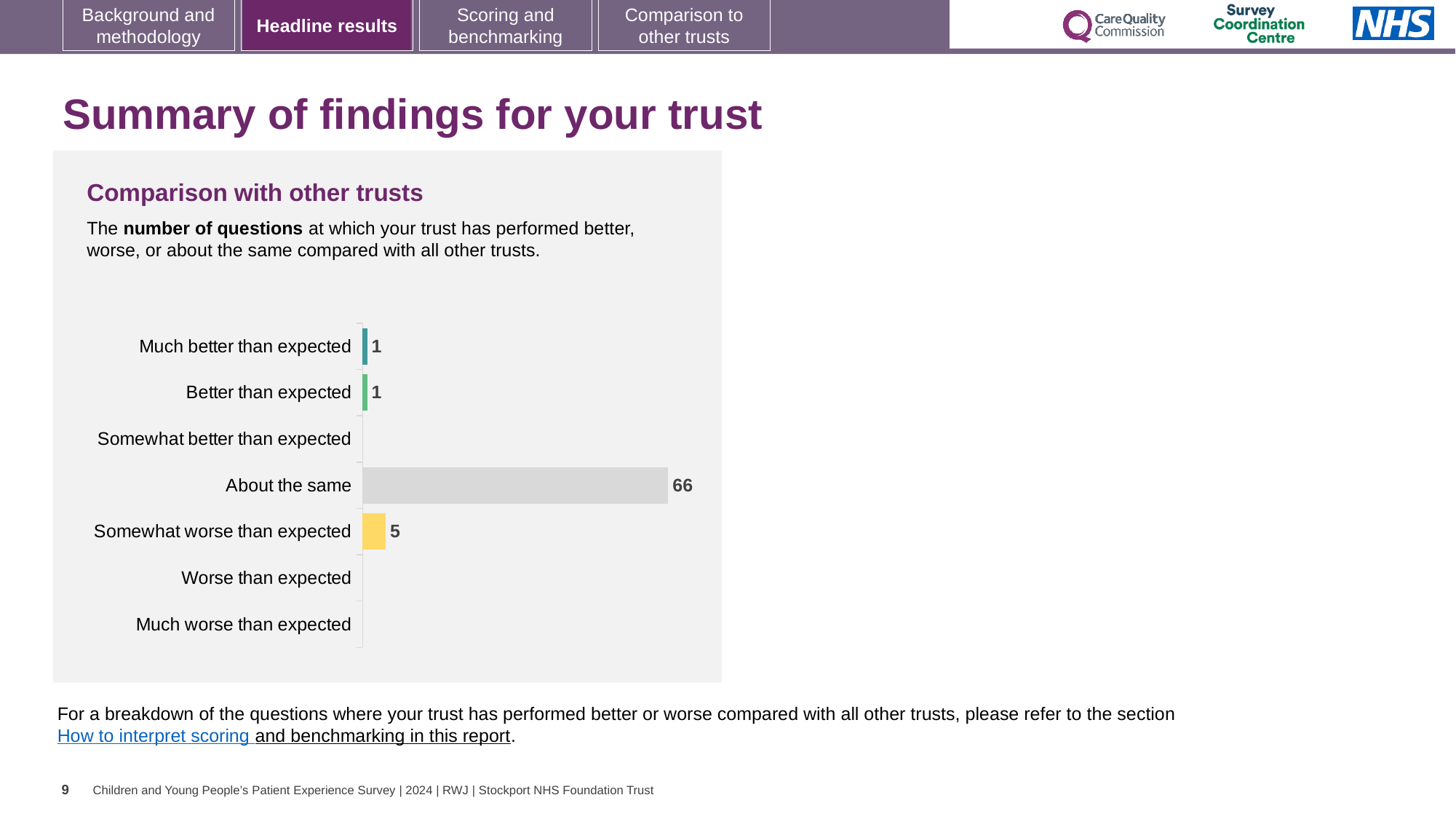
What is the value for 'About the same'? 66 What is the value for 'Somewhat worse than expected'? 5 What is the value for 'Better than expected'? 1 What is the value for 'Much better than expected'? 1 Which category has the highest value? About the same What kind of chart is shown on the slide? Bar chart Which is larger, the value for 'Somewhat worse than expected' or the value for 'Much better than expected'? Somewhat worse than expected What is the difference between the values for 'About the same' and 'Somewhat worse than expected'? 61 How many categories are listed on the chart's axis? 7 What is the difference between the values for 'Somewhat worse than expected' and 'Better than expected'? 4 What colour is the bar for 'Somewhat worse than expected'? Yellow What is the title of the chart section? Comparison with other trusts